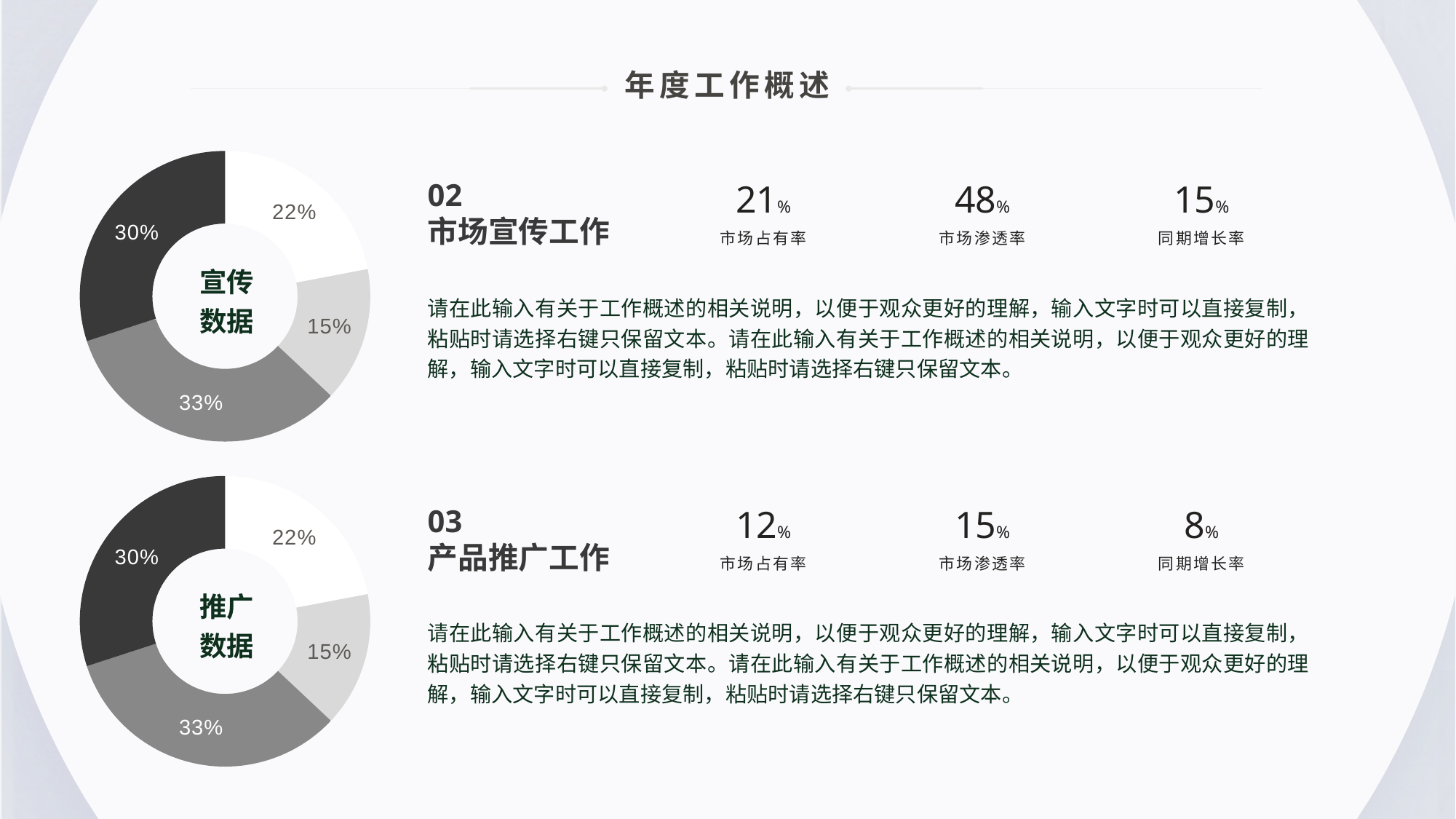
In the bottom chart (推广数据), which is larger: the dark (black) slice or the light gray slice? The dark (black) slice In the top chart (宣传数据), what is the smallest slice's value? 15% How many slices does the top chart (宣传数据) have? 4 What is the text shown in the centre of the bottom chart? 推广数据 In the bottom chart (推广数据), what is the difference between the dark slice (30%) and the white slice (22%)? 8% In the bottom chart (推广数据), what share does the medium gray slice represent? 33% In the top chart (宣传数据), what share does the dark (black) slice represent? 30% In the top chart (宣传数据), what is the largest slice's value? 33% In the top chart (宣传数据), what share does the white slice represent? 22% What kind of chart is the top chart labelled 宣传数据? Doughnut chart What is the text shown in the centre of the top chart? 宣传数据 In the top chart (宣传数据), what is the difference between the largest slice (33%) and the smallest slice (15%)? 18%